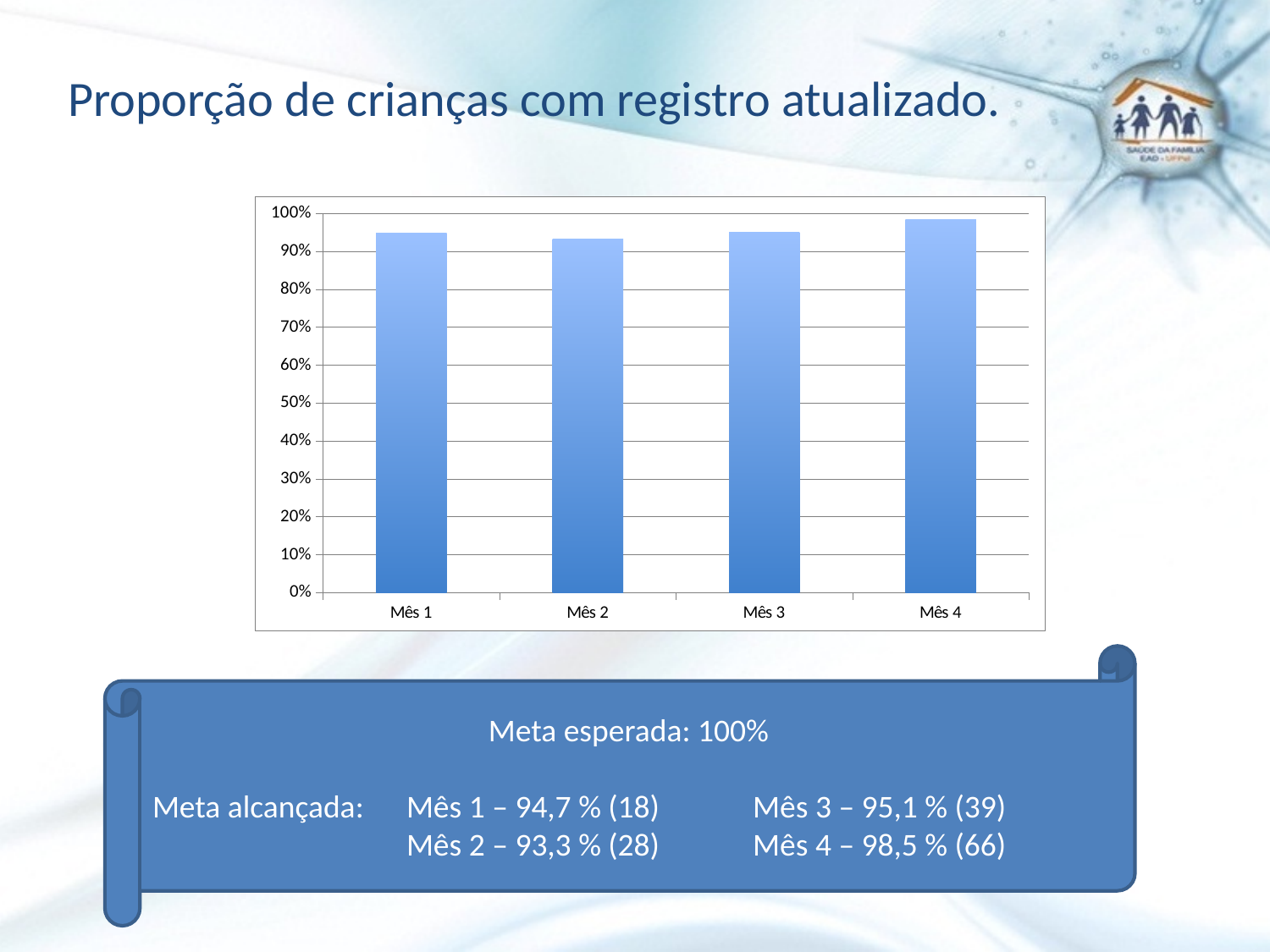
What is the title of the slide containing the chart? Proporção de crianças com registro atualizado. Which month has the highest proportion of children with updated records? Mês 4 How many months (categories) are plotted in the chart? 4 Which month has the lowest proportion of children with updated records? Mês 2 Which is larger, the value for Mês 4 or the value for Mês 2? Mês 4 What is the proportion of children with updated records in Mês 2? 93,3 % What kind of chart is shown on the slide? bar chart Is the value for Mês 2 greater or less than 90%? greater What is the proportion of children with updated records in Mês 4? 98,5 % Is the value for Mês 4 greater or less than 100%? less What is the proportion of children with updated records in Mês 1? 94,7 % What is the difference in percentage points between Mês 4 (98,5 %) and Mês 2 (93,3 %)? 5,2